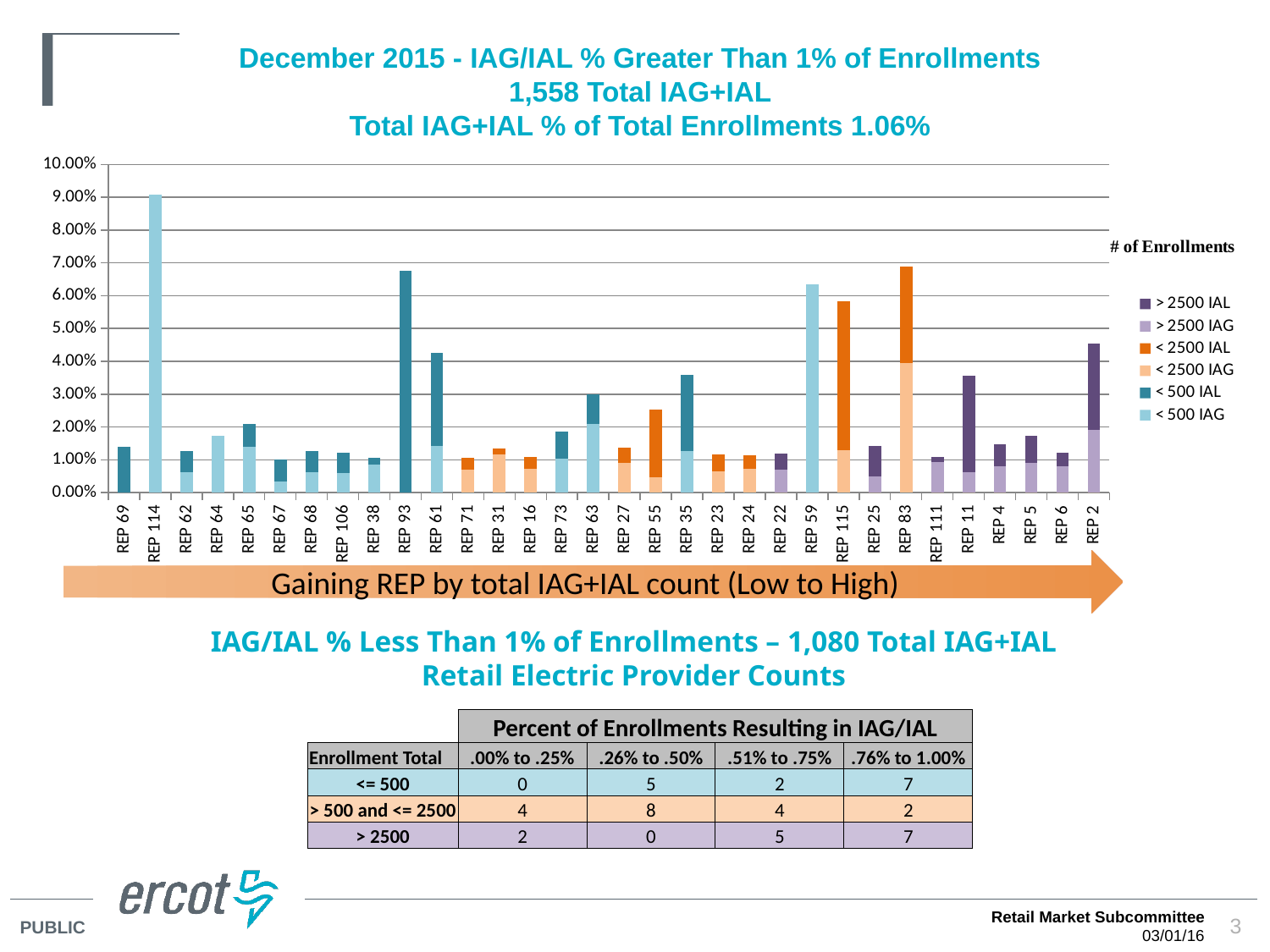
What is the heading shown above the chart legend? # of Enrollments Which REP has the highest total bar in the chart? REP 114 Is the value for REP 114 greater or less than 8.00%? greater Is the value for REP 11 greater or less than 3.00%? greater How many series does the chart legend list? 6 Which bar is taller, REP 83 or REP 115? REP 83 Is the value for REP 2 greater or less than 4.00%? greater Which bar is taller, REP 114 or REP 93? REP 114 What kind of chart is shown on the slide? Stacked bar chart How many REP categories are plotted along the x axis of the chart? 32